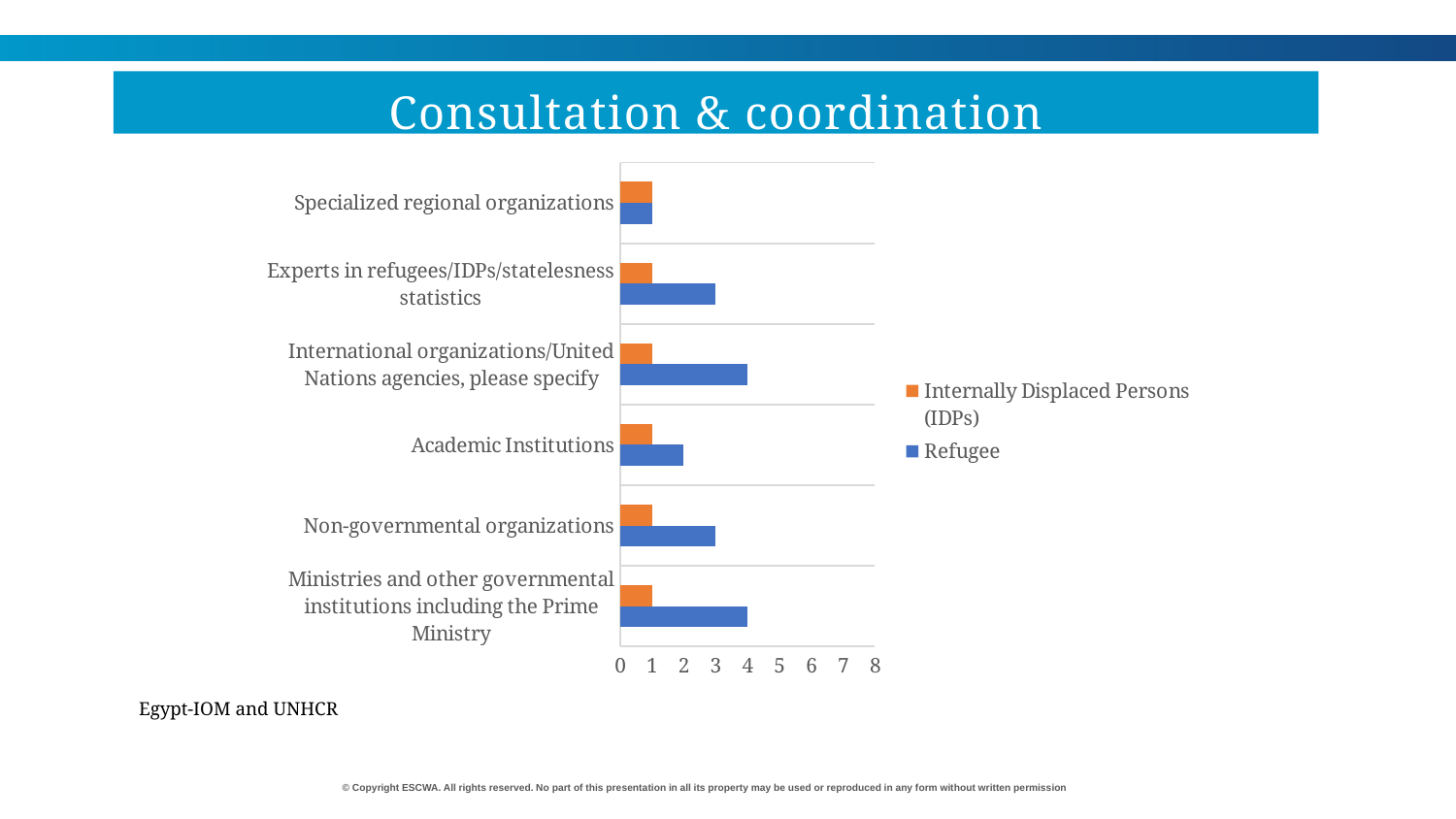
Is the Refugee value for Non-governmental organizations greater or less than 2? greater What is the Refugee value for Academic Institutions? 2 What is the Refugee value for International organizations/United Nations agencies, please specify? 4 What is the difference between the Refugee value for Experts in refugees/IDPs/statelessness statistics and the Refugee value for Specialized regional organizations? 2 Which category has the lowest Refugee value? Specialized regional organizations What kind of chart is shown on the slide? bar chart What is the title of the chart? Consultation & coordination Which is larger: the Refugee value for Ministries and other governmental institutions including the Prime Ministry or the Refugee value for Academic Institutions? Ministries and other governmental institutions including the Prime Ministry How many series does the legend list? 2 What is the Internally Displaced Persons (IDPs) value for Non-governmental organizations? 1 How many categories are shown on the chart? 6 Which colour represents the Internally Displaced Persons (IDPs) series? orange